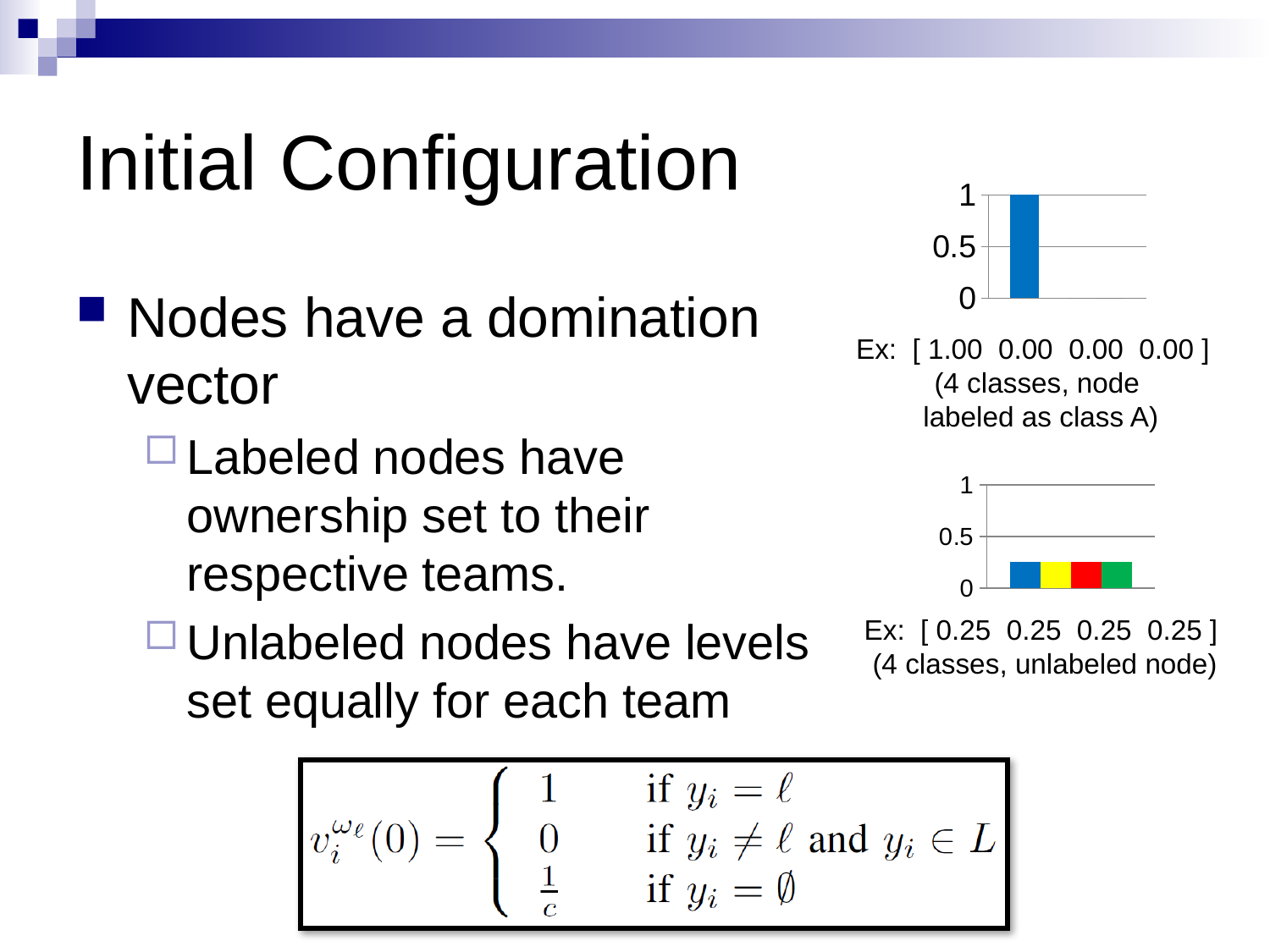
How many bars are there in the bottom chart on the right? 4 In the bottom chart on the right, is the value of the blue bar greater or less than 0.5? less How many visible bars are there in the top chart on the right? 1 In the top chart on the right, is the value of the blue bar greater or less than 0.5? greater In the bottom chart on the right, is the value of the green bar greater or less than 0.5? less What is the highest tick value shown on the vertical axis of the bottom chart on the right? 1 Which is taller: the blue bar in the top chart on the right or the blue bar in the bottom chart on the right? the blue bar in the top chart In the top chart on the right, what value does the blue bar reach on the vertical axis? 1 What colours are the four bars in the bottom chart on the right, from left to right? blue, yellow, red, green What kind of chart is the bottom chart on the right side of the slide? bar chart What kind of chart is the top chart on the right side of the slide? bar chart In the bottom chart on the right, are the four bars the same height? yes